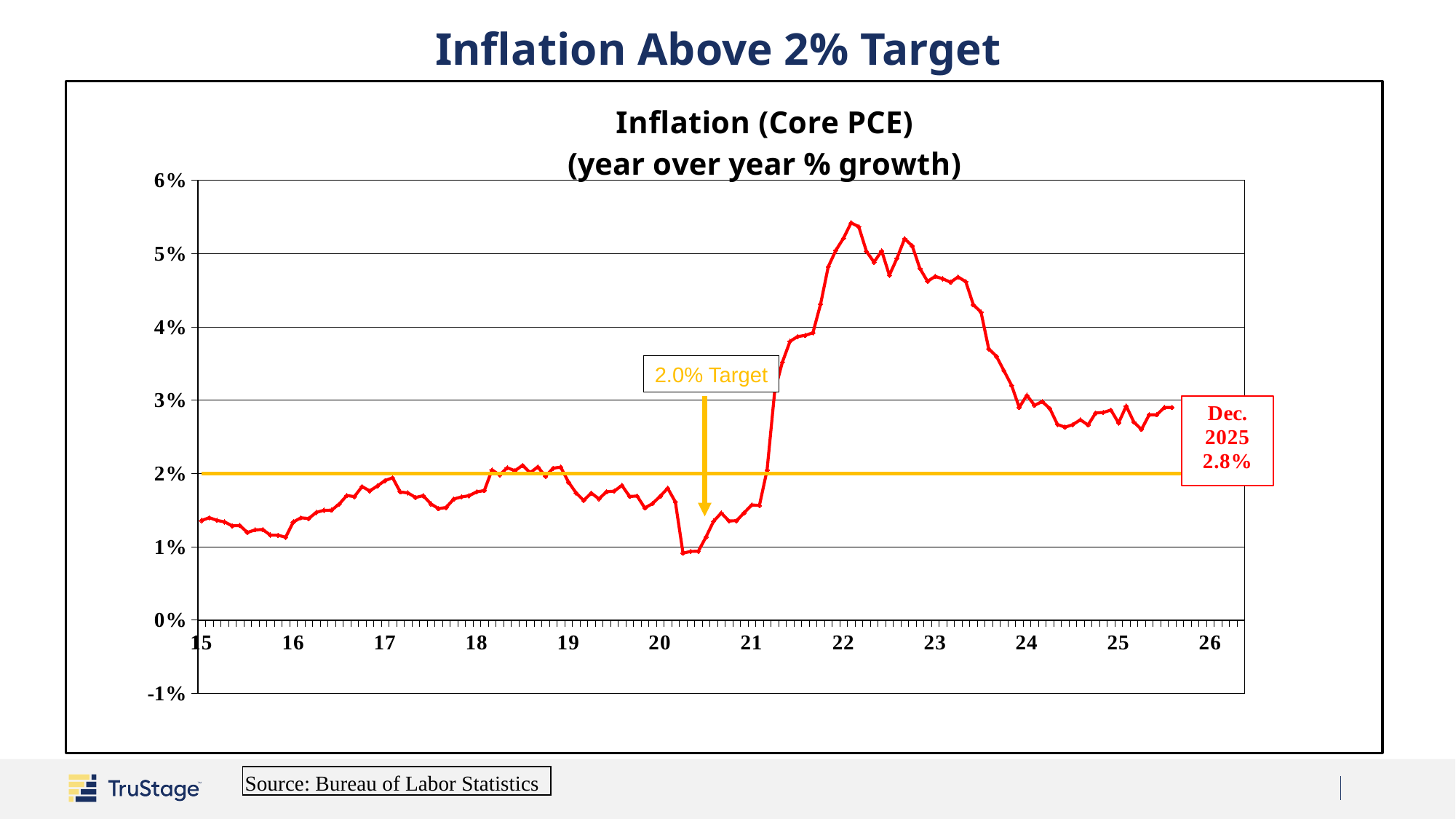
Is the peak value of the inflation line in 2022 greater or less than 5%? greater What inflation target is marked by the horizontal line on the chart? 2.0% What is the title of the chart? Inflation (Core PCE) (year over year % growth) Does the inflation line rise or fall between 2021 and 2022? rise Does the inflation line rise or fall between its 2022 peak and 2024? fall What kind of chart is shown on the slide? line chart Is the inflation value at the start of 2015 greater or less than 2%? less What is the Core PCE inflation value labeled for Dec. 2025? 2.8% By how many percentage points does the Dec. 2025 value of 2.8% exceed the 2.0% target? 0.8 percentage points Is the inflation value at the start of 2023 greater or less than 4%? greater Is the Dec. 2025 value of 2.8% larger or smaller than the 2.0% target? larger In which year does the inflation line reach its highest point? 2022